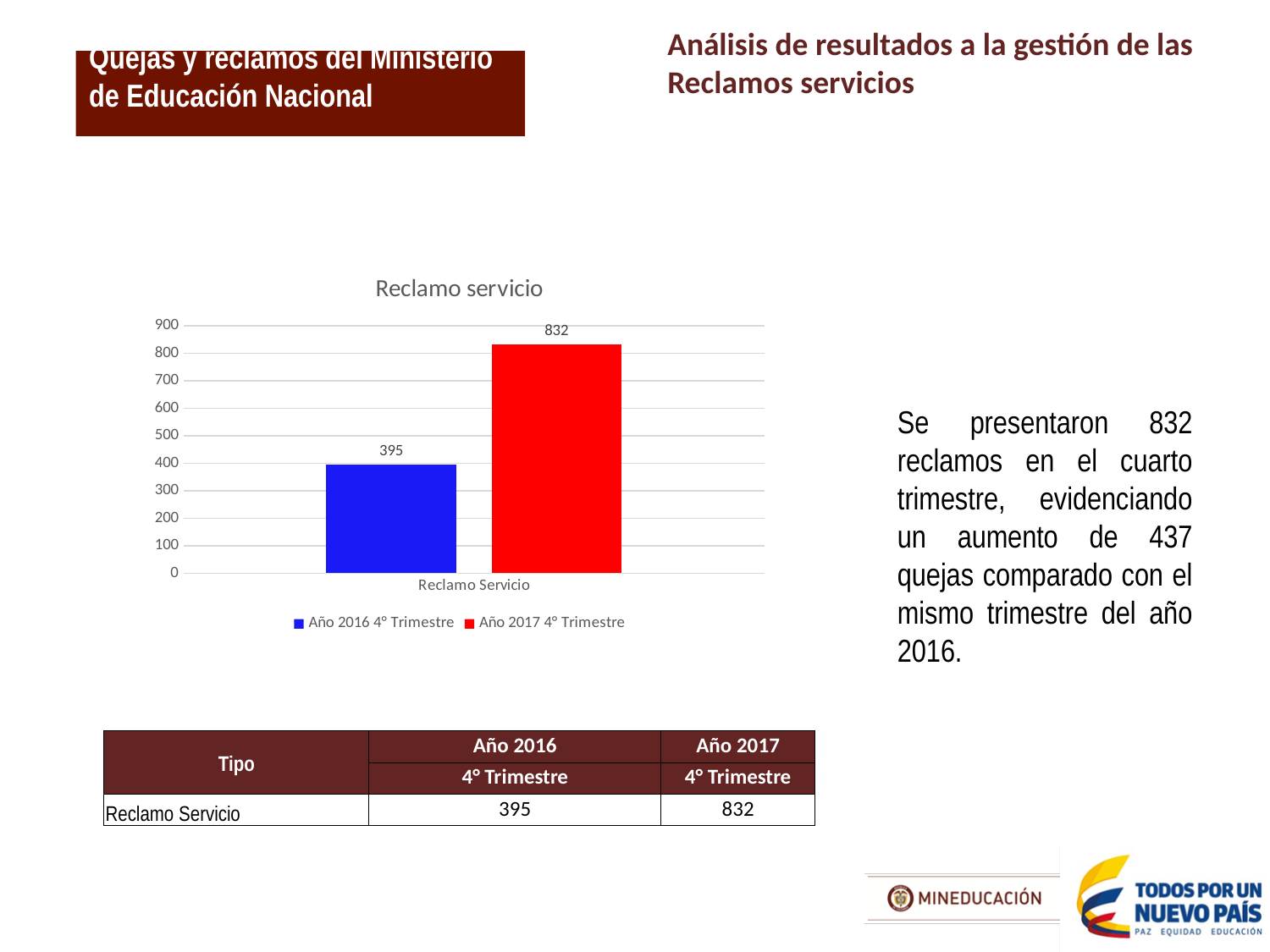
What is the title of the chart? Reclamo servicio Is the value for Año 2017 4° Trimestre greater or less than 800? greater Is the value for Año 2016 4° Trimestre larger or smaller than the value for Año 2017 4° Trimestre? smaller What is the difference between the Año 2017 4° Trimestre and Año 2016 4° Trimestre values in the chart? 437 What kind of chart is shown on the slide? bar chart Which series has the lower value in the Reclamo servicio chart? Año 2016 4° Trimestre What is the value for Año 2017 4° Trimestre in the Reclamo servicio chart? 832 Which series has the higher value in the Reclamo servicio chart? Año 2017 4° Trimestre What colour is the bar for Año 2017 4° Trimestre? red Is the value for Año 2016 4° Trimestre greater or less than 400? less How many series does the legend of the chart list? 2 What is the value for Año 2016 4° Trimestre in the Reclamo servicio chart? 395